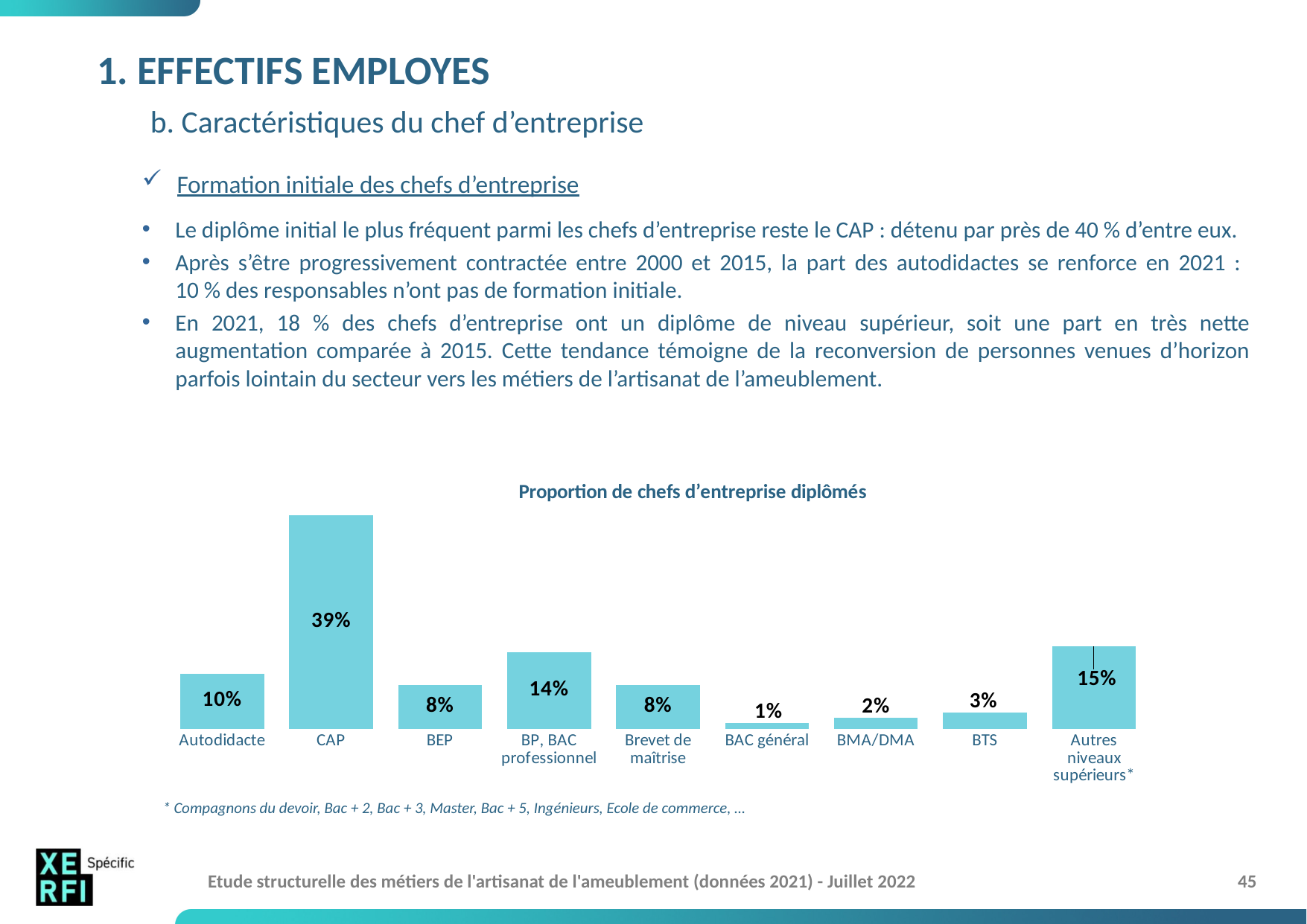
What is the value for BP, BAC professionnel? 14% What is the title of the chart? Proportion de chefs d’entreprise diplômés What is the difference between the values for CAP and Autodidacte? 29% What kind of chart is shown on the slide? Bar chart Which is larger, the value for BTS or the value for BMA/DMA? BTS Which category has the highest value? CAP How many categories are shown in the chart? 9 What is the difference between the values for Autres niveaux supérieurs and BP, BAC professionnel? 1% Which category has the lowest value? BAC général What is the value for Autres niveaux supérieurs? 15% What is the value for CAP? 39% What is the value for Autodidacte? 10%